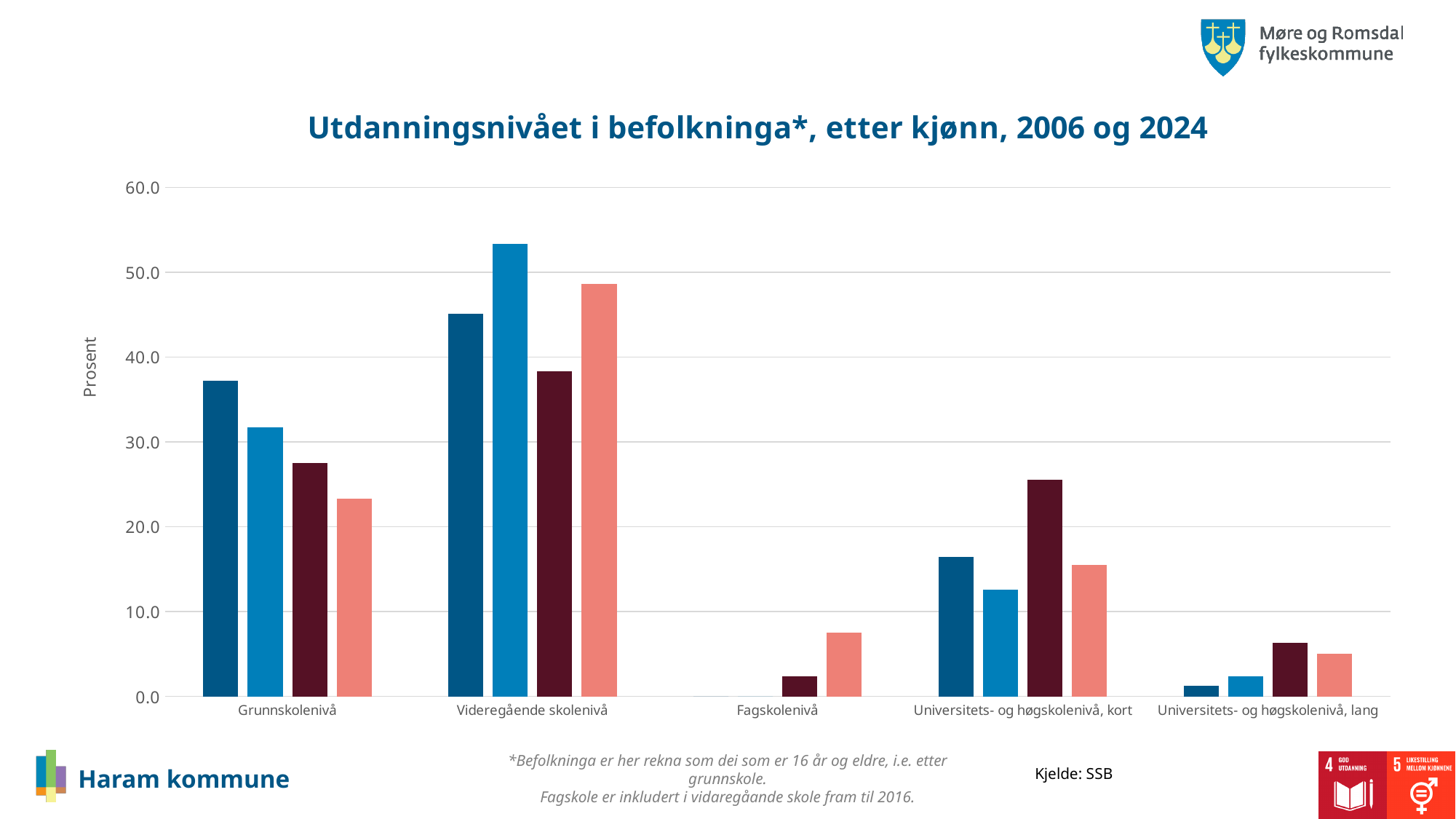
What source is cited below the chart? SSB Which category has the tallest bars in the chart? Videregående skolenivå Is the value of the dark blue (first) bar for Universitets- og høgskolenivå, lang greater or less than 10? less Is the value of the light blue (second) bar for Videregående skolenivå greater or less than 50? greater Is the value of the salmon (last) bar for Fagskolenivå greater or less than 10? less What kind of chart is shown on the slide? bar chart For Grunnskolenivå, which is larger: the dark blue (first) bar or the salmon (last) bar? the dark blue (first) bar How many education-level categories are shown on the x axis? 5 What is the title of the chart? Utdanningsnivået i befolkninga*, etter kjønn, 2006 og 2024 For Videregående skolenivå, which is larger: the light blue (second) bar or the dark red (third) bar? the light blue (second) bar